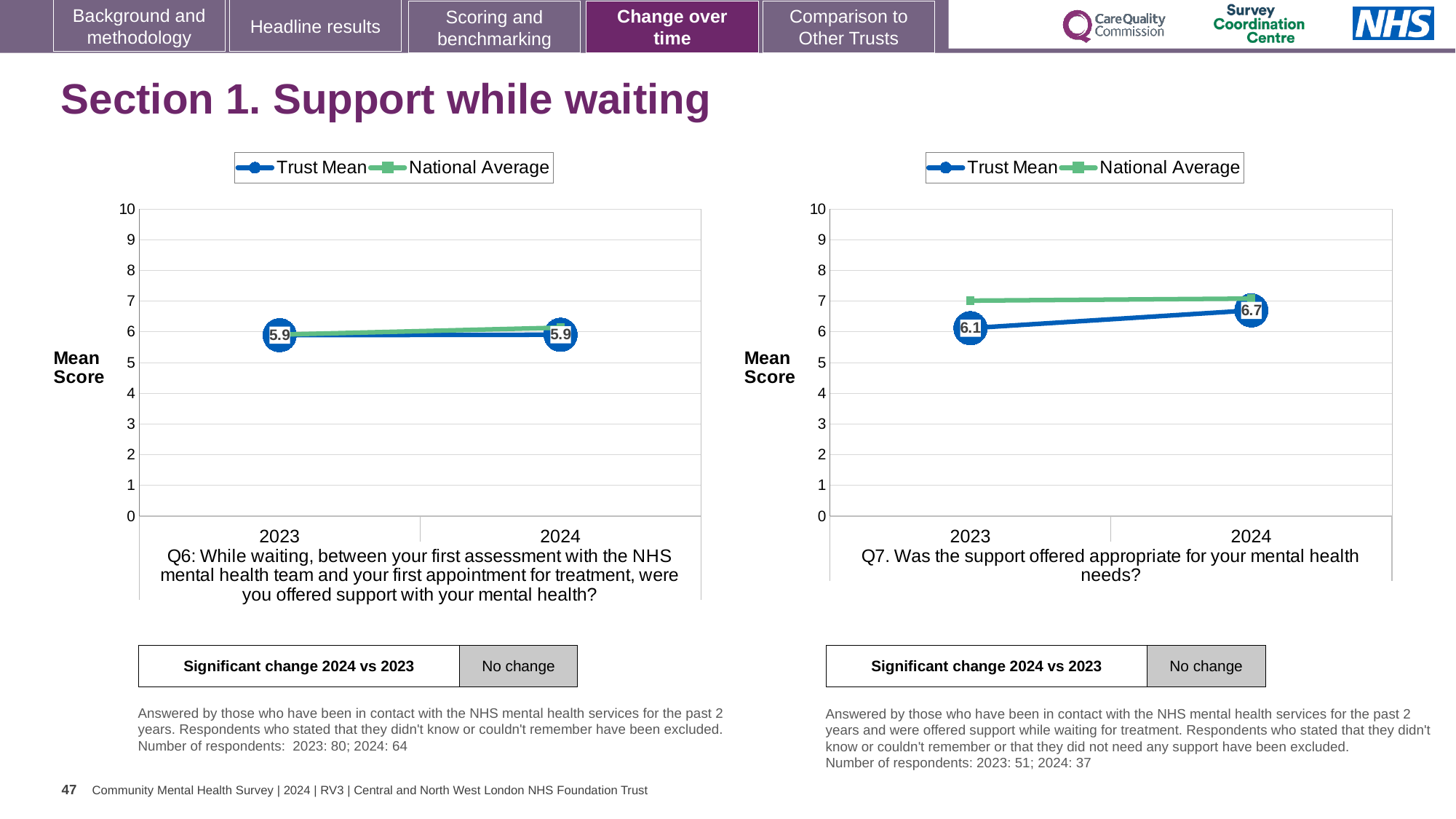
How many years are plotted on the x axis of the left chart (Q6)? 2 In the right chart (Q7), what is the Trust Mean score for 2024? 6.7 In the right chart (Q7), does the Trust Mean rise or fall from 2023 to 2024? rise In the right chart (Q7), is the National Average for 2023 greater or less than 6? greater In the right chart (Q7), is the Trust Mean higher in 2023 or 2024? 2024 In the left chart (Q6), what is the Trust Mean score for 2023? 5.9 In the right chart (Q7), by how much did the Trust Mean change from 2023 to 2024? 0.6 What type of chart is used for Q7 on the right? line chart In the right chart (Q7), what is the Trust Mean score for 2023? 6.1 In the right chart (Q7), which series is higher in 2023, Trust Mean or National Average? National Average In the left chart (Q6), what is the Trust Mean score for 2024? 5.9 How many series does the legend of the left chart (Q6) list? 2